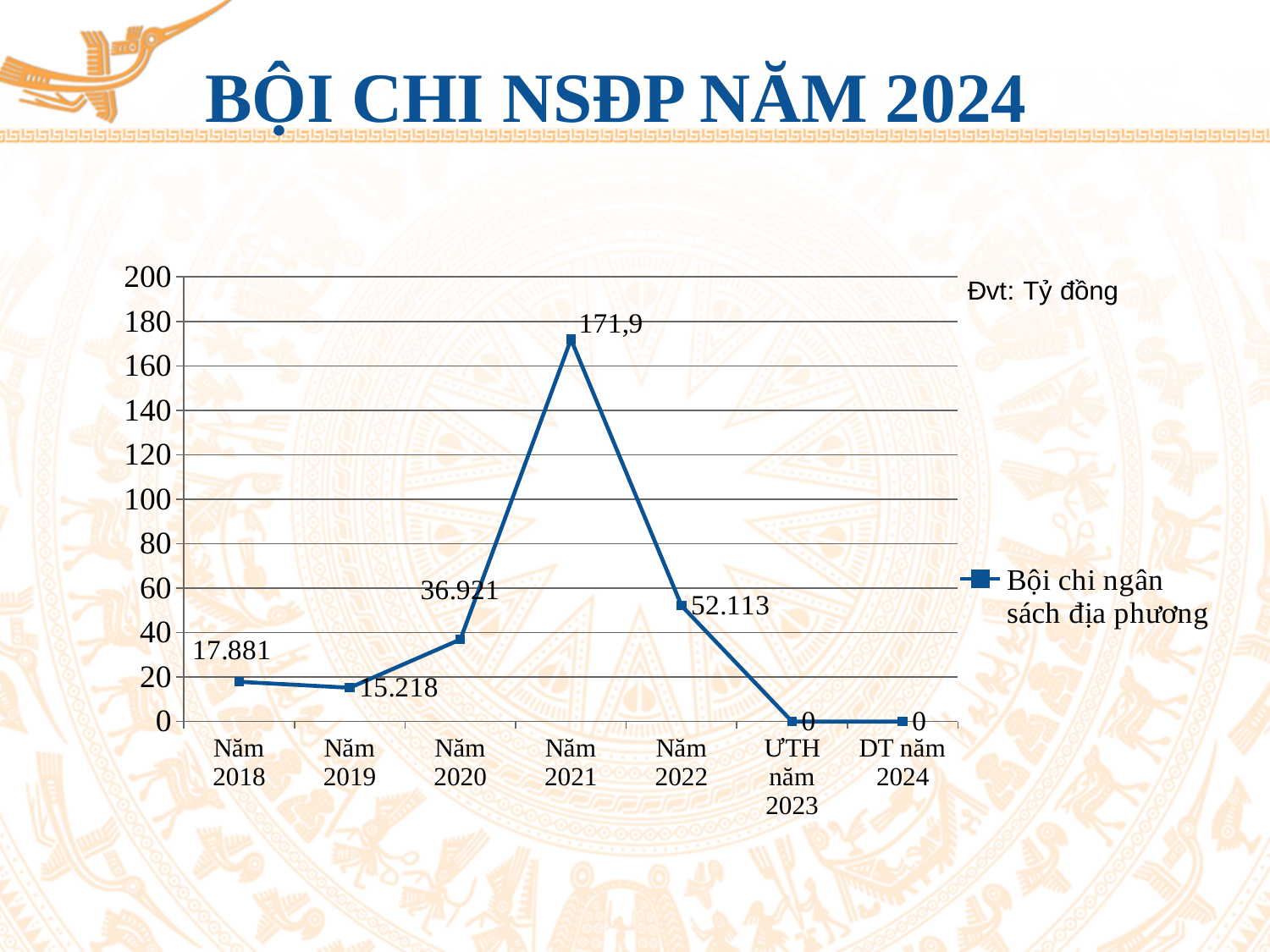
Which is larger, the value for Năm 2019 or the value for Năm 2020? Năm 2020 What is the value for Năm 2020? 36.921 What is the value for Năm 2022? 52.113 What is the value for Năm 2021? 171,9 How many categories are plotted on the x axis? 7 What is the value for DT năm 2024? 0 What unit is stated for the chart values? Tỷ đồng Which category has the highest value? Năm 2021 What is the difference between the values for Năm 2022 and Năm 2020? 15.192 What type of chart is shown on the slide? line chart What is the value for Năm 2018? 17.881 How many series does the legend list? 1